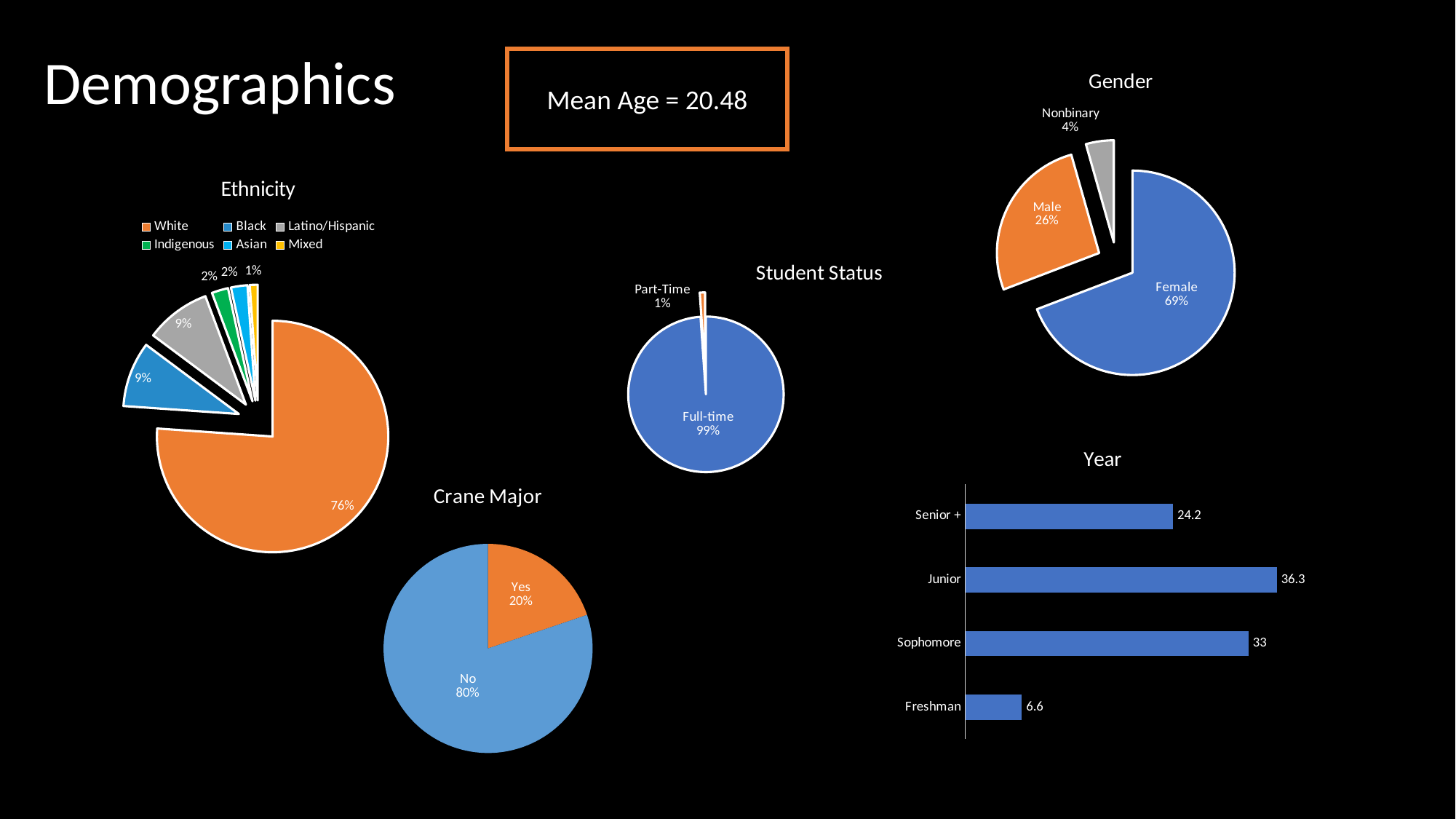
In the Gender pie chart, which is larger, Male or Nonbinary? Male In the Year chart, what is the difference between the Junior and Senior + values? 12.1 How many entries does the legend of the Ethnicity pie chart list? 6 In the Year chart, what is the value for Junior? 36.3 In the Year chart, which category has the highest value? Junior In the Year chart, what is the value for Freshman? 6.6 In the Ethnicity pie chart, what share is White? 76% In the Crane Major pie chart, what share is No? 80% In the Year chart, how many categories are shown? 4 In the Year chart, which category has the lowest value? Freshman In the Gender pie chart, what share is Female? 69% What kind of chart is the Year chart? Bar chart